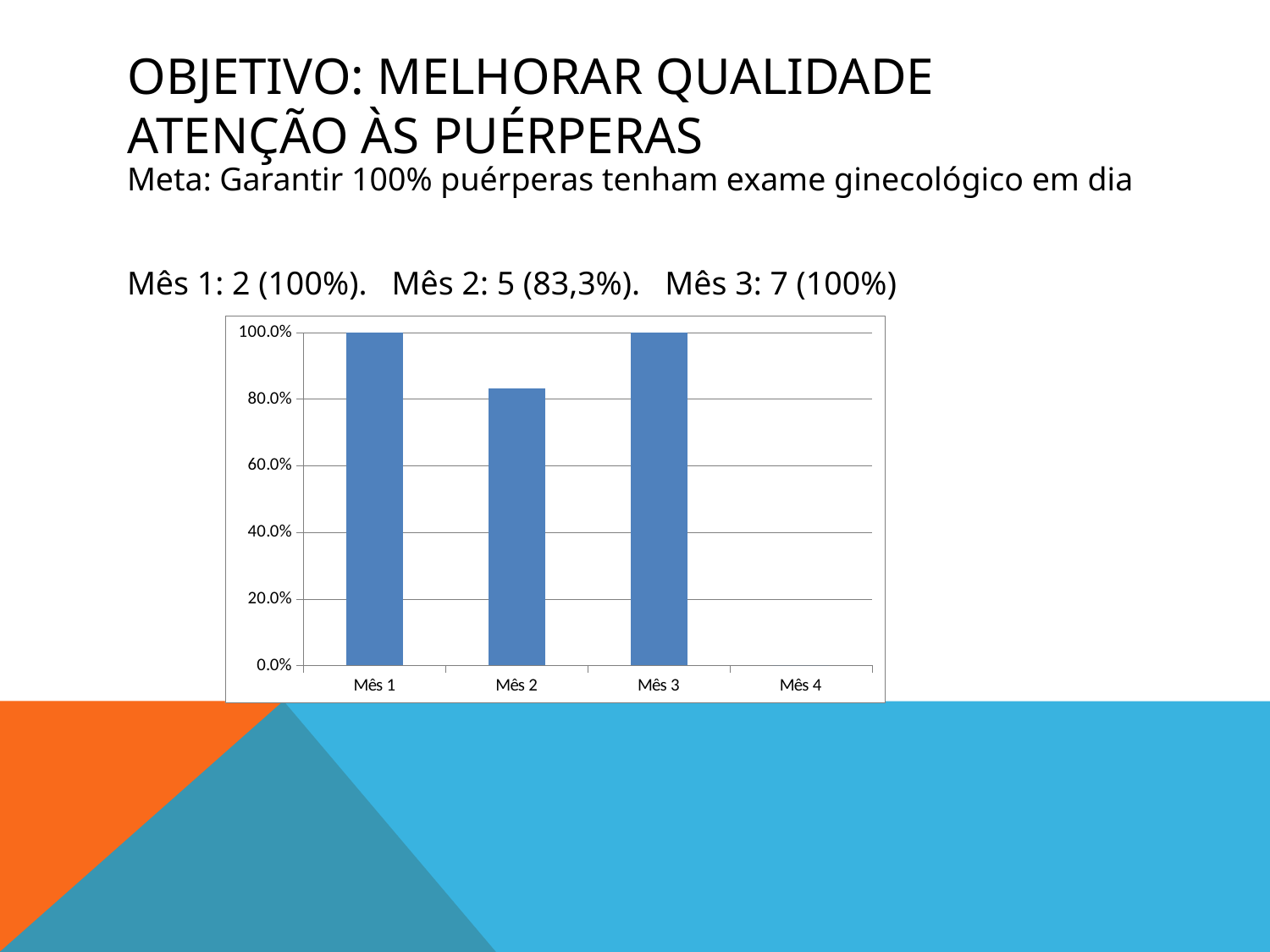
How many month categories are shown on the x axis of the chart? 4 Is the value for Mês 2 greater or less than 80.0%? greater What is the value of the bar for Mês 1? 100.0% Which is larger, the value for Mês 1 or the value for Mês 2? Mês 1 Which is larger, the value for Mês 3 or the value for Mês 2? Mês 3 What is the highest tick value shown on the y axis of the chart? 100.0% Which month category has no bar plotted in the chart? Mês 4 Do the bar values rise steadily from Mês 1 to Mês 3? No What type of chart is shown on the slide? bar chart According to the slide, what percentage is reported for Mês 2? 83,3% What is the value of the bar for Mês 3? 100.0% Is the value for Mês 2 greater or less than 100.0%? less